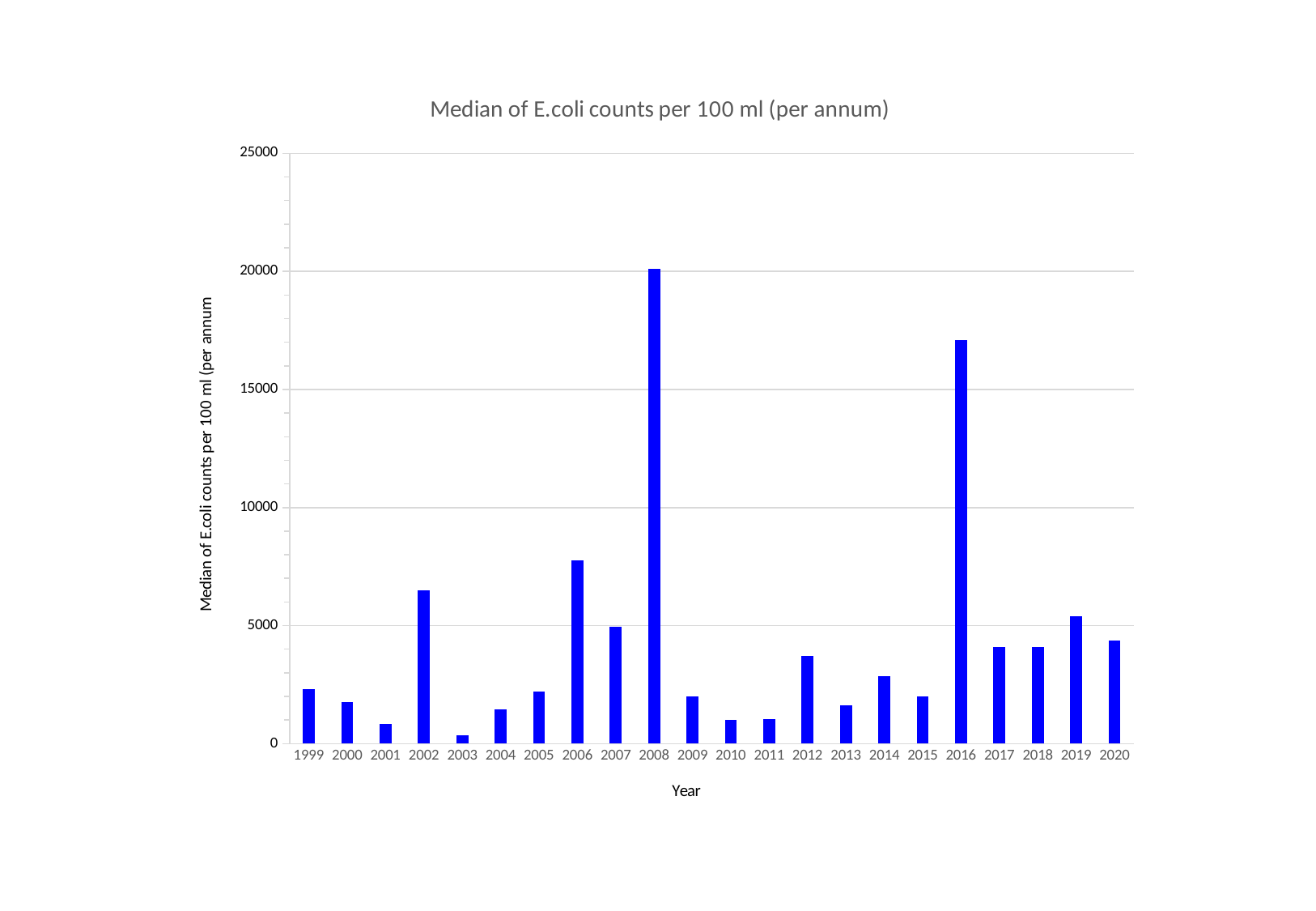
Is the value for 2006 greater or less than 5000? greater Is the value for 2012 greater or less than 5000? less How many years are plotted on the x axis? 22 What is the title of the chart? Median of E.coli counts per 100 ml (per annum) Which year has the highest median E.coli count? 2008 What kind of chart is shown on the slide? bar chart Which year has the lowest median E.coli count? 2003 Which year has the higher median E.coli count, 2008 or 2016? 2008 Is the value for 2008 greater or less than 15000? greater What is the label of the x axis? Year Which year has the higher median E.coli count, 2002 or 2006? 2006